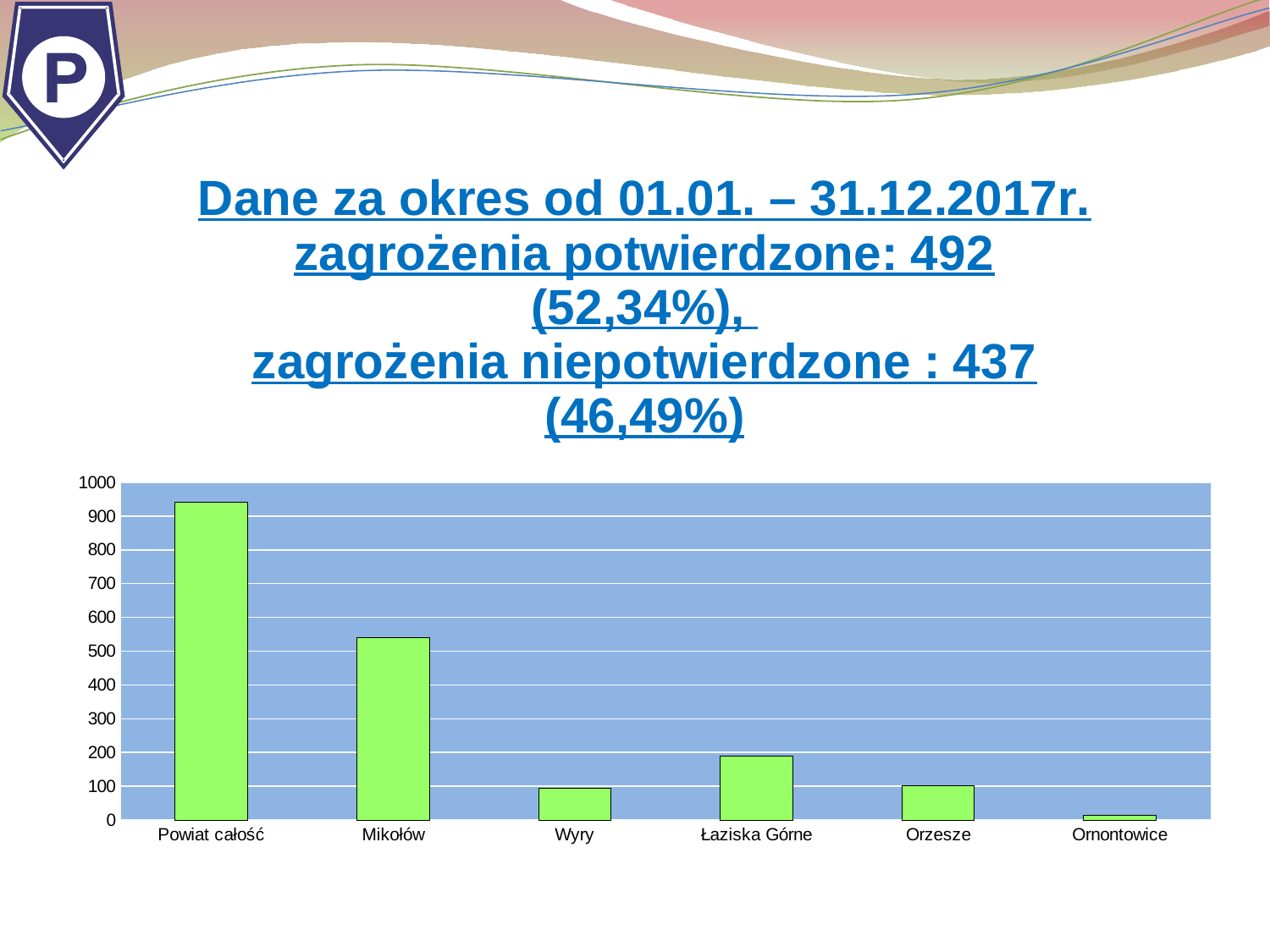
Which is larger, the value for Mikołów or the value for Łaziska Górne? Mikołów Is the value for Łaziska Górne greater or less than 100? greater How many categories are shown on the x axis of the chart? 6 Is the value for Ornontowice greater or less than 100? less Which category has the lowest bar in the chart? Ornontowice What colour are the bars in the chart? green Is the value for Powiat całość greater or less than 900? greater What kind of chart is shown on the slide? bar chart Which is larger, the value for Łaziska Górne or the value for Orzesze? Łaziska Górne Which category has the highest bar in the chart? Powiat całość